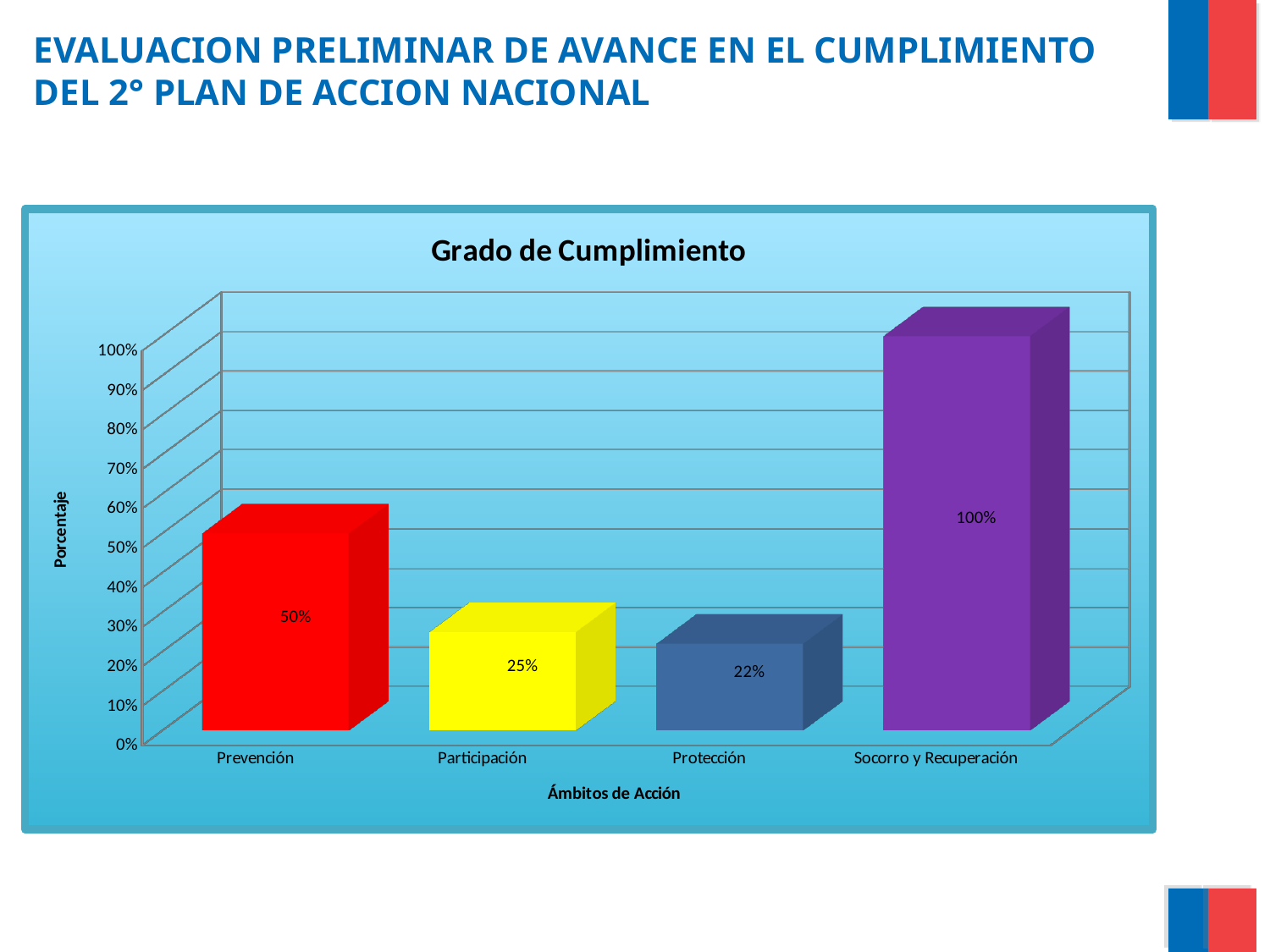
How many categories are shown on the x axis? 4 What is the difference between the values for Socorro y Recuperación and Prevención? 50% Which category has the highest value? Socorro y Recuperación What is the title of the chart? Grado de Cumplimiento Which is larger, the value for Prevención or the value for Participación? Prevención Which category has the lowest value? Protección What kind of chart is this? Bar chart What is the value for Participación? 25% What is the value for Socorro y Recuperación? 100% What is the value for Prevención? 50% What is the value for Protección? 22% What is the difference between the values for Participación and Protección? 3%